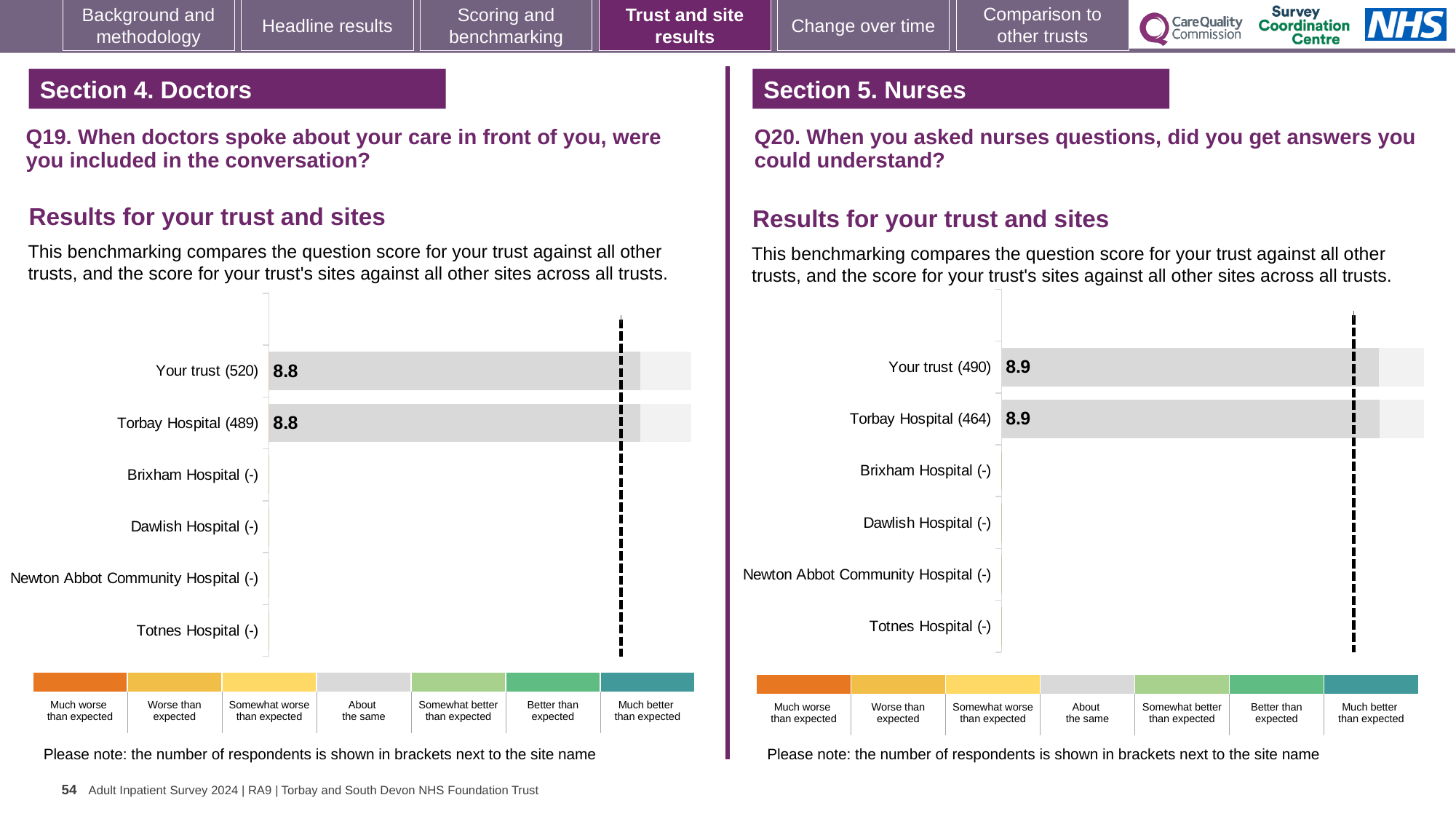
What kind of chart is used for the Q19 results on the left? Bar chart In the Q20 chart on the right, how many sites have no score shown (marked with a dash)? 4 In the Q20 chart on the right, what is the score for Torbay Hospital? 8.9 In the Q20 chart on the right, is the score for Your trust greater or less than the score for Torbay Hospital, or are they equal? Equal How many sites or categories are listed on the y axis of the Q20 chart on the right? 6 In the Q20 chart on the right, what is the score for Your trust? 8.9 In the Q19 chart on the left, what is the score for Torbay Hospital? 8.8 In the Q19 chart on the left, what is the difference between the scores for Your trust and Torbay Hospital? 0 In the Q19 chart on the left, how many respondents are shown in brackets for Your trust? 520 In the Q19 chart on the left, what is the score for Your trust? 8.8 How many sites or categories are listed on the y axis of the Q19 chart on the left? 6 In the Q20 chart on the right, how many respondents are shown in brackets for Torbay Hospital? 464